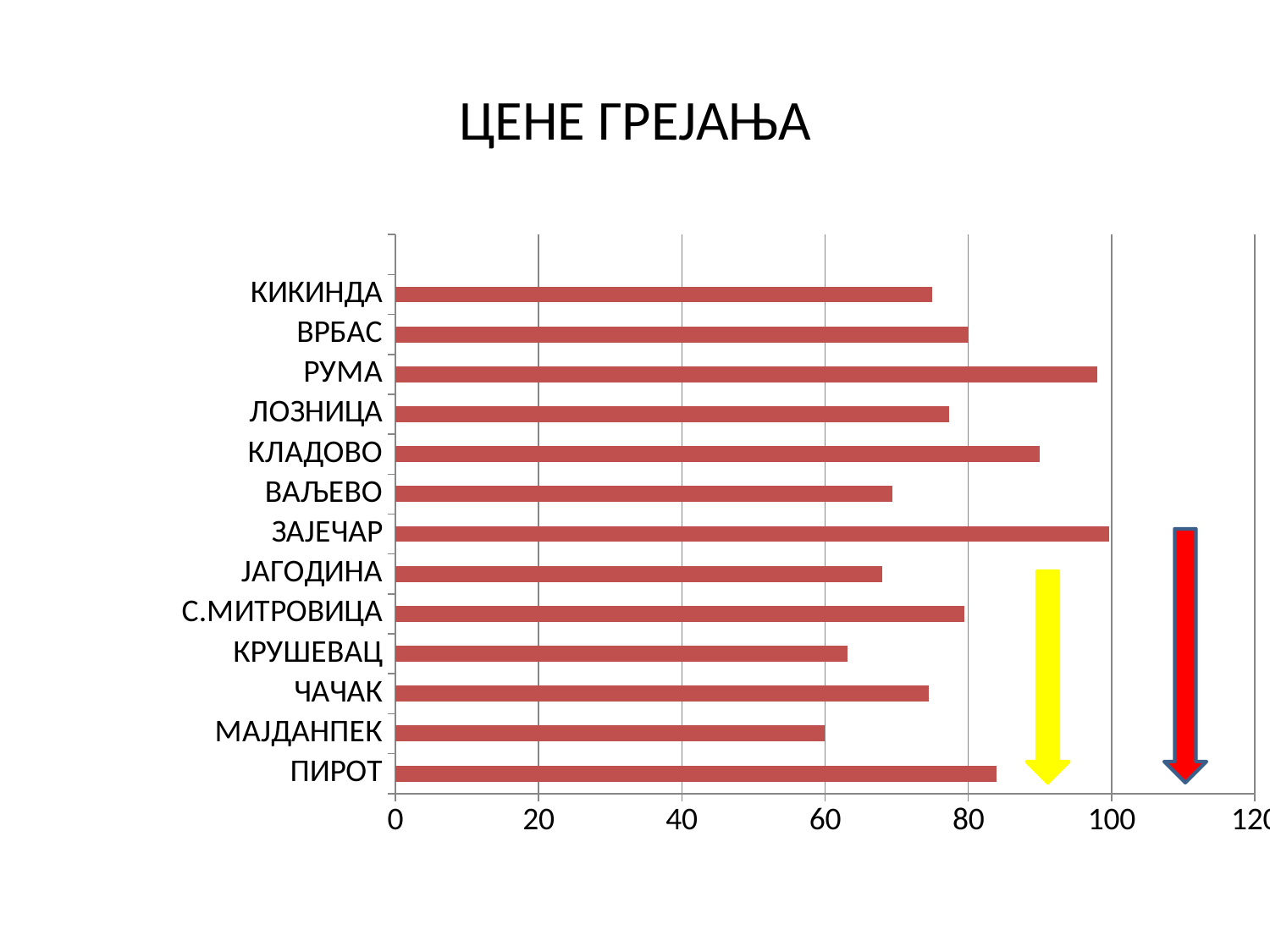
Is the value for ЗАЈЕЧАР greater or less than 80? greater Which has the larger value, ПИРОТ or КРУШЕВАЦ? ПИРОТ Is the value for КИКИНДА greater or less than 80? less Is the value for ЈАГОДИНА greater or less than 80? less Which has the larger value, КЛАДОВО or ЈАГОДИНА? КЛАДОВО What is the title of the chart? ЦЕНЕ ГРЕЈАЊА Which has the larger value, РУМА or ВАЉЕВО? РУМА How many categories (cities) are plotted in the chart? 13 What type of chart is shown on the slide? bar chart